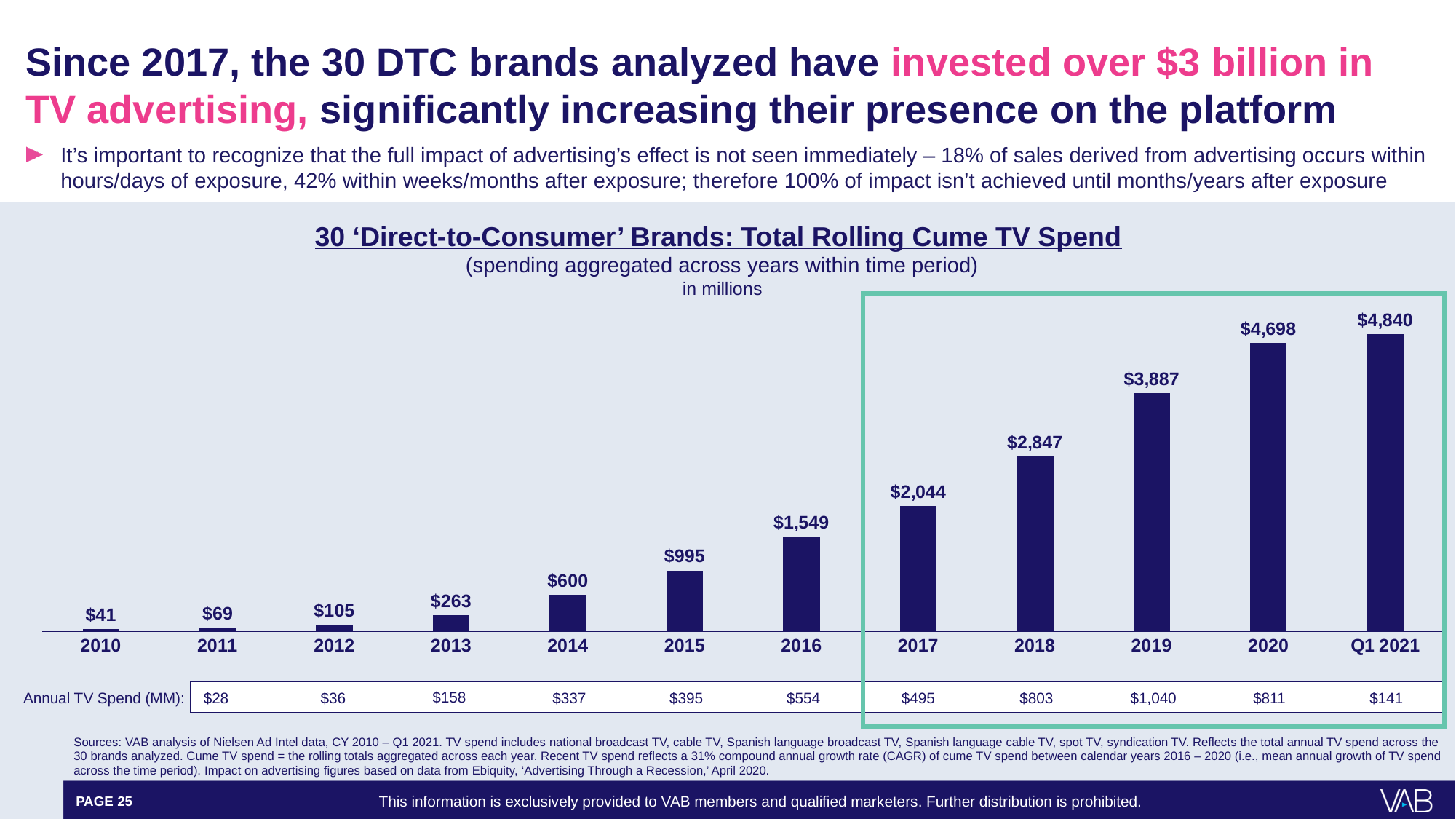
What is the title of the chart? 30 'Direct-to-Consumer' Brands: Total Rolling Cume TV Spend What kind of chart is shown on the slide? Bar chart Which is larger, the cume TV spend for 2014 or 2015? 2015 What is the difference between the cume TV spend for 2020 and 2019? $811 What is the cume TV spend value shown for 2016? $1,549 Do the cume TV spend values rise or fall from 2010 to Q1 2021? Rise Which period has the highest cume TV spend? Q1 2021 What is the cume TV spend value shown for 2019? $3,887 Which year has the lowest cume TV spend? 2010 What is the cume TV spend value shown for 2010? $41 How many periods are shown on the x axis of the chart? 12 What is the difference between the cume TV spend for 2018 and 2017? $803